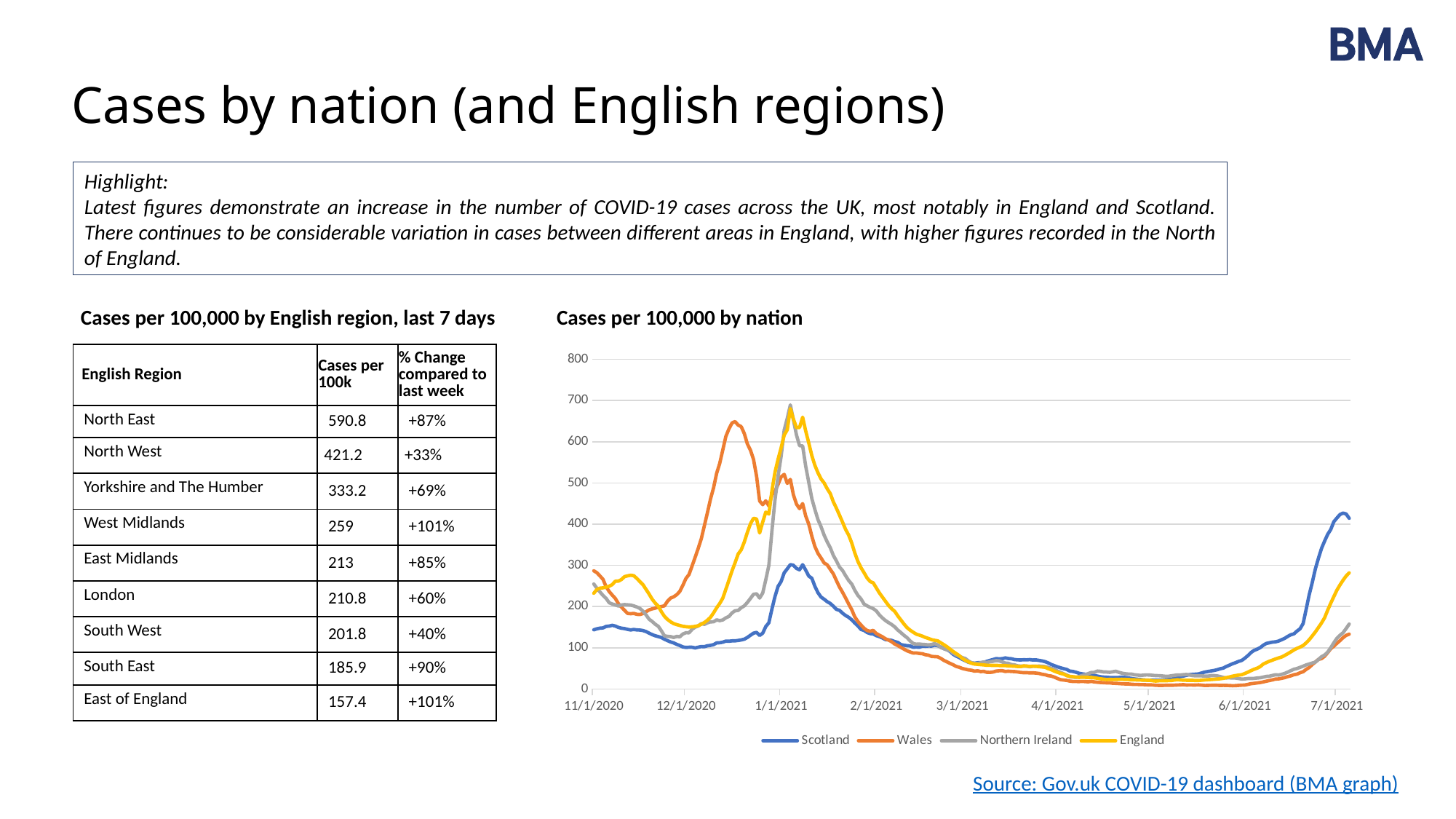
In the 'Cases per 100,000 by nation' chart, which colour is the Scotland line? Blue How many series does the legend of the 'Cases per 100,000 by nation' chart list? 4 In the 'Cases per 100,000 by nation' chart, is the peak value for Wales in December 2020 greater or less than 600? greater In the 'Cases per 100,000 by nation' chart, is the value for Scotland at 5/1/2021 greater or less than 100? less What kind of chart is 'Cases per 100,000 by nation'? Line chart In the 'Cases per 100,000 by nation' chart, is the value for England at 7/1/2021 greater or less than 300? less In the 'Cases per 100,000 by nation' chart, which nation has the highest value at 7/1/2021? Scotland In the 'Cases per 100,000 by nation' chart, at 7/1/2021 is the value for Scotland or for Wales larger? Scotland In the 'Cases per 100,000 by nation' chart, does the Scotland line rise or fall between 6/1/2021 and 7/1/2021? Rise Which nations are listed in the legend of the 'Cases per 100,000 by nation' chart? Scotland, Wales, Northern Ireland, England In the 'Cases per 100,000 by nation' chart, which nation has the lowest peak value over the whole period? Scotland